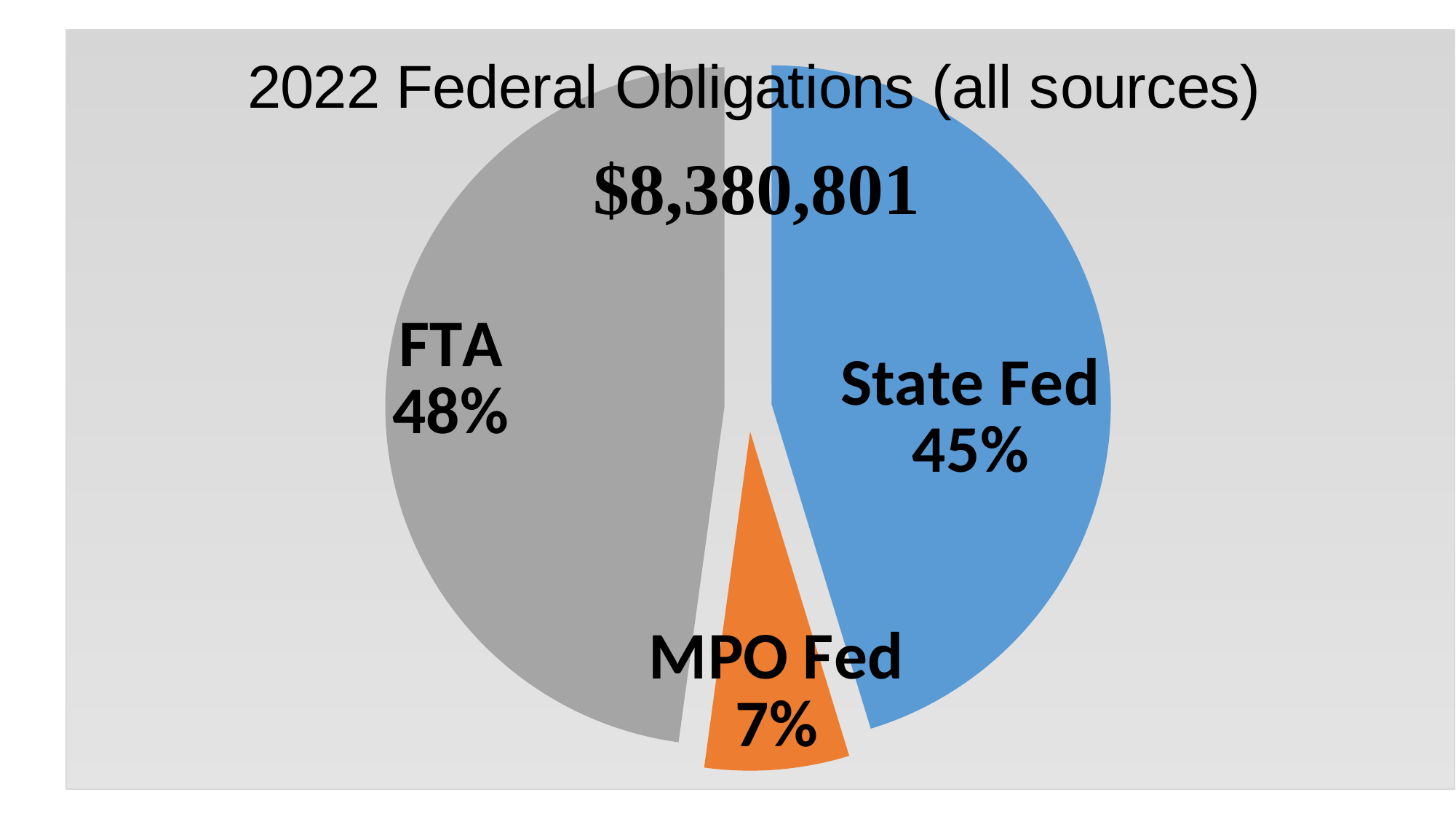
Which category has the smallest slice of the pie? MPO Fed What share of the pie does State Fed represent? 45% What is the title of the chart? 2022 Federal Obligations (all sources) Which category has the largest slice of the pie? FTA What is the difference in percentage points between the FTA and State Fed slices? 3% What is the difference in percentage points between the State Fed and MPO Fed slices? 38% How many slices does the pie chart have? 3 What kind of chart is shown on the slide? pie chart What share of the pie does MPO Fed represent? 7% What total dollar amount is printed on the chart? $8,380,801 What share of the pie does FTA represent? 48% Which is larger, the FTA slice or the MPO Fed slice? FTA